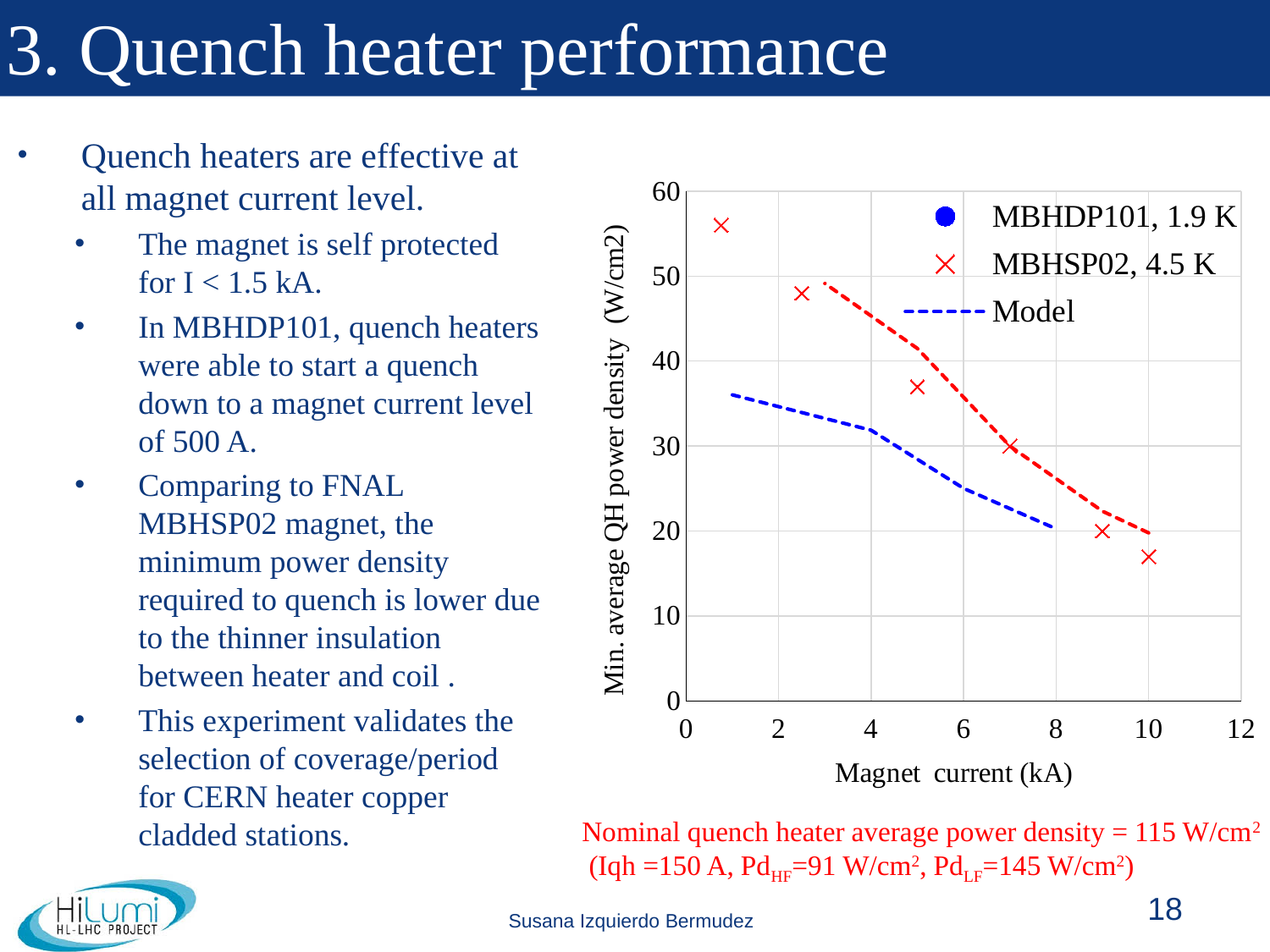
Is the MBHSP02, 4.5 K value at the lowest magnet current (about 1 kA) greater or less than 50 W/cm2? greater Is the MBHSP02, 4.5 K value at about 2.5 kA greater or less than 40 W/cm2? greater Is the MBHSP02, 4.5 K value at about 10 kA greater or less than 20 W/cm2? less What is the highest value shown on the y axis of the chart? 60 What kind of chart is shown on the slide? scatter chart How many entries does the chart legend list? 3 As magnet current increases, does the minimum average QH power density for MBHSP02, 4.5 K rise or fall? fall Which legend entry is drawn as a blue dashed line? Model How many MBHSP02, 4.5 K data points (red crosses) are plotted on the chart? 6 What is the label of the x axis of the chart? Magnet current (kA) Which MBHSP02, 4.5 K data point has the highest minimum average QH power density: the one at the lowest magnet current or the one at the highest magnet current? the one at the lowest magnet current